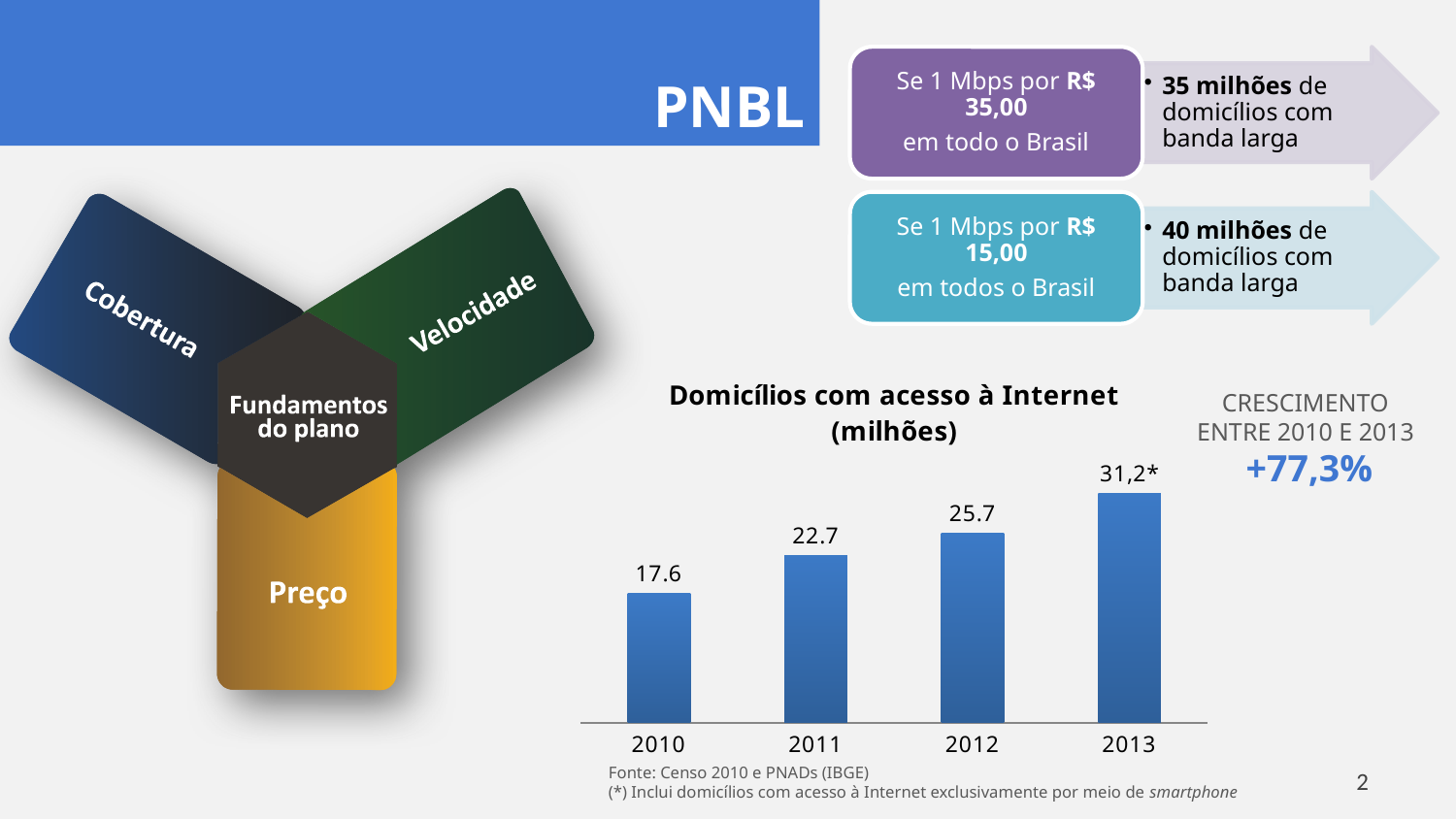
What is the title of the chart on the slide? Domicílios com acesso à Internet (milhões) What is the difference between the values for 2011 and 2010? 5.1 What is the value for 2010 in the chart? 17.6 Which year has the highest value in the chart? 2013 Do the values in the chart rise or fall from 2010 to 2013? rise What is the value for 2011 in the chart? 22.7 How many years are shown on the x axis of the chart? 4 Which year has the lowest value in the chart? 2010 What is the difference between the values for 2012 and 2011? 3.0 What kind of chart is shown under the title "Domicílios com acesso à Internet (milhões)"? bar chart What is the data label shown for 2013 in the chart? 31,2* What is the value for 2012 in the chart? 25.7